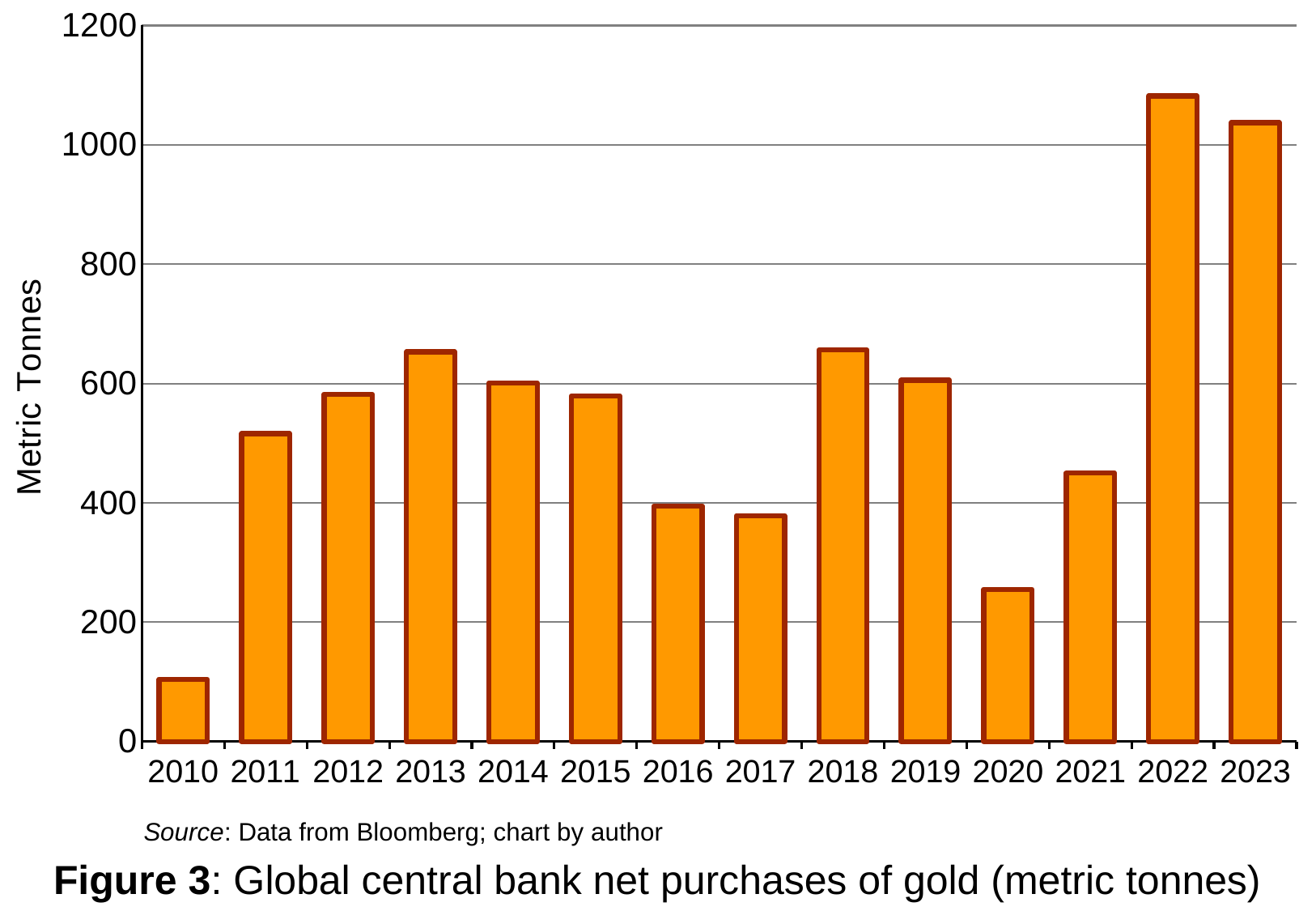
Which year has the larger value, 2020 or 2021? 2021 Is the value for 2021 greater or less than 600? less What is the label on the vertical axis? Metric Tonnes Which year has the highest central bank net purchases of gold? 2022 Is the value for 2010 greater or less than 200? less How many years are plotted on the chart? 14 Which year has the lowest central bank net purchases of gold? 2010 Which year has the larger value, 2022 or 2023? 2022 Is the value for 2013 greater or less than 600? greater Do the values rise or fall from 2020 to 2022? rise What kind of chart is shown on the slide? bar chart